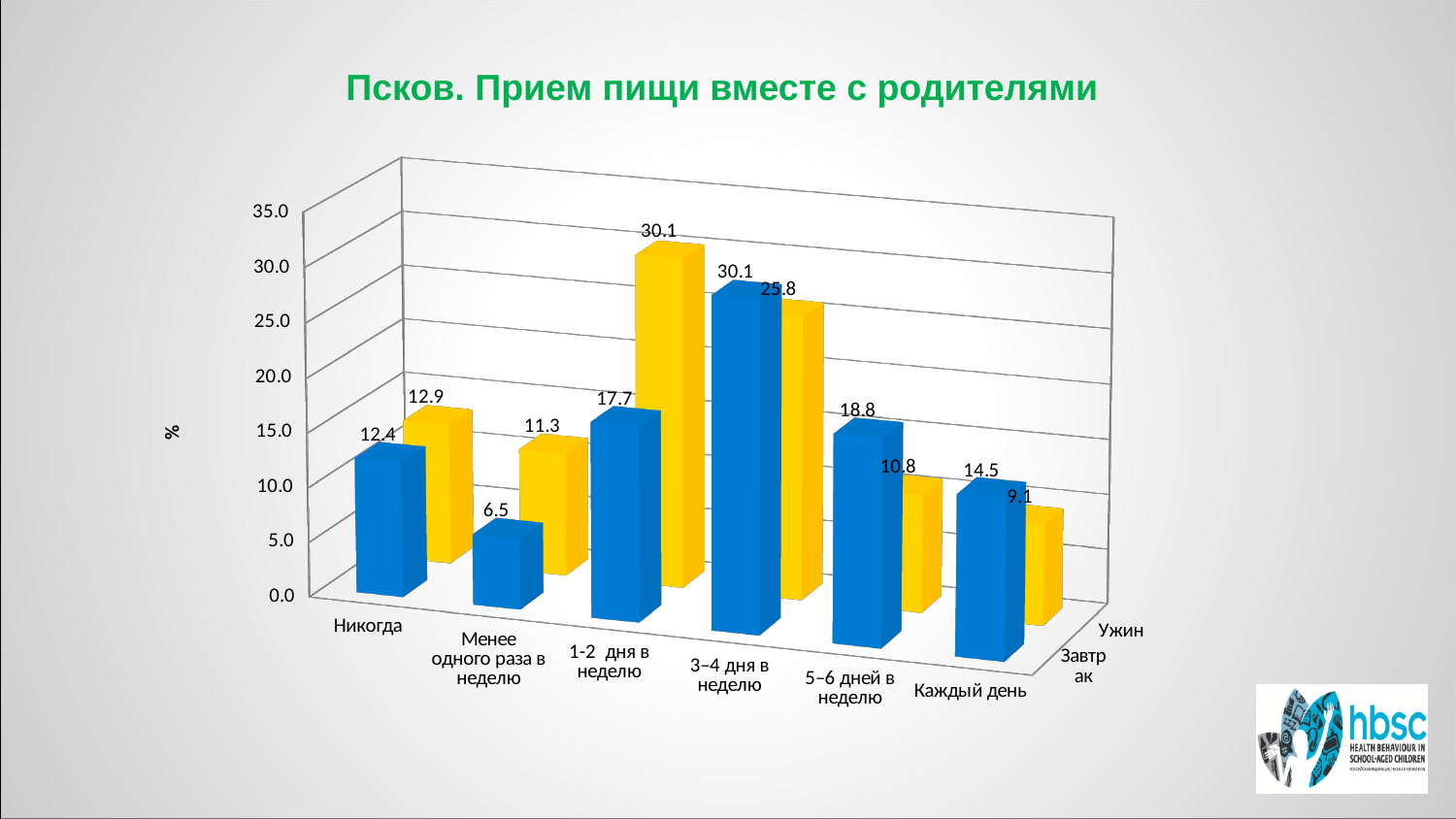
What is the value for Завтрак in the 5–6 дней в неделю category? 18.8 What is the value for Ужин in the Каждый день category? 9.1 What kind of chart is shown on the slide? Bar chart What is the title of the chart? Псков. Прием пищи вместе с родителями What is the value for Ужин in the Менее одного раза в неделю category? 11.3 Which category has the lowest value for Завтрак? Менее одного раза в неделю Which category has the highest value for Ужин? 1-2 дня в неделю Which category has the highest value for Завтрак? 3–4 дня в неделю What is the difference between the Завтрак and Ужин values in the 3–4 дня в неделю category? 4.3 What is the value for Завтрак in the Никогда category? 12.4 Which is larger in the Менее одного раза в неделю category, Завтрак or Ужин? Ужин How many categories are shown on the x axis? 6